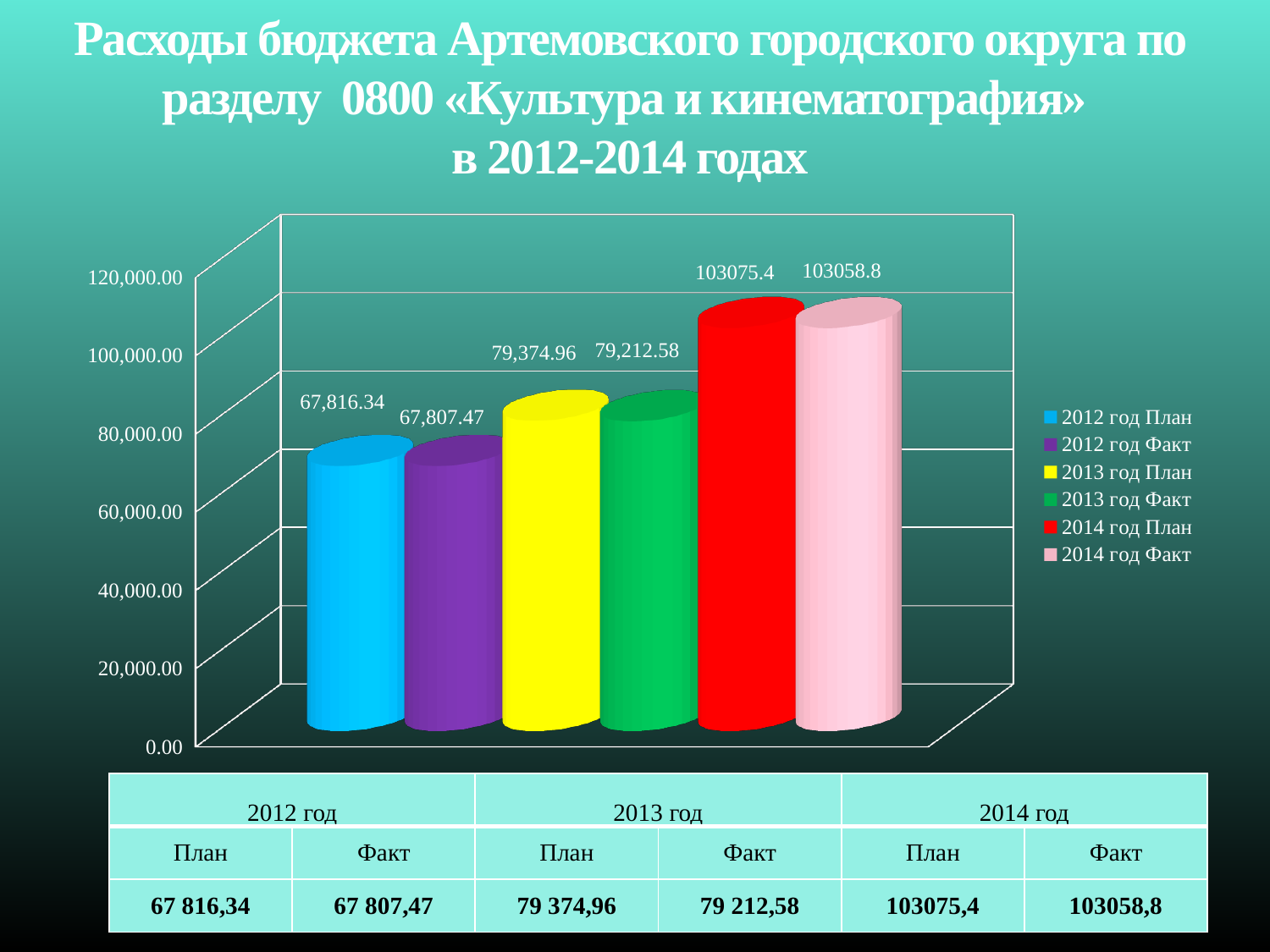
What is the difference between 2014 год План and 2014 год Факт? 16.6 What is the value shown for 2013 год Факт? 79,212.58 Which is larger, the value for 2013 год План or the value for 2012 год План? 2013 год План What is the difference between 2013 год План and 2013 год Факт? 162.38 What is the value shown for 2014 год План? 103075.4 What is the value shown for 2012 год План? 67,816.34 What kind of chart is shown on the slide? bar chart Is the value for 2012 год План greater or less than 80,000.00? less Which series has the highest value on the chart? 2014 год План Which series has the lowest value on the chart? 2012 год Факт How many series does the legend list? 6 What is the value shown for 2014 год Факт? 103058.8